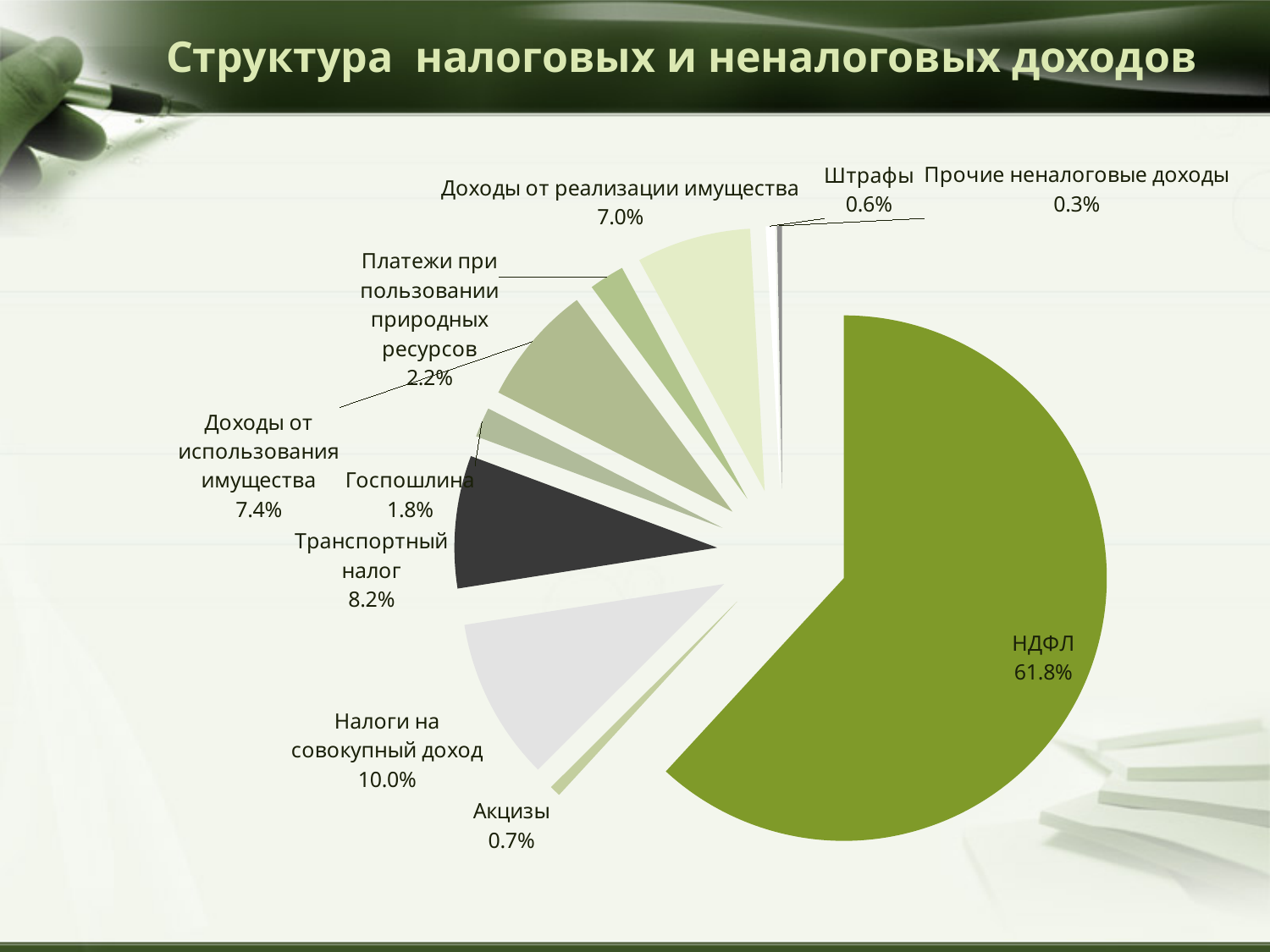
What is the title of the slide? Структура налоговых и неналоговых доходов Which category has the largest slice of the pie? НДФЛ How many categories are shown in the pie chart? 10 What share of the pie does НДФЛ account for? 61.8% What percentage is shown for Транспортный налог? 8.2% Which is larger: Доходы от использования имущества or Доходы от реализации имущества? Доходы от использования имущества What is the difference between the shares of Налоги на совокупный доход and Транспортный налог? 1.8% Which category has the smallest slice of the pie? Прочие неналоговые доходы What is the value for Доходы от реализации имущества? 7.0% What percentage is labelled for Штрафы? 0.6% What is the value shown for Налоги на совокупный доход? 10.0% What type of chart is shown on the slide? Pie chart